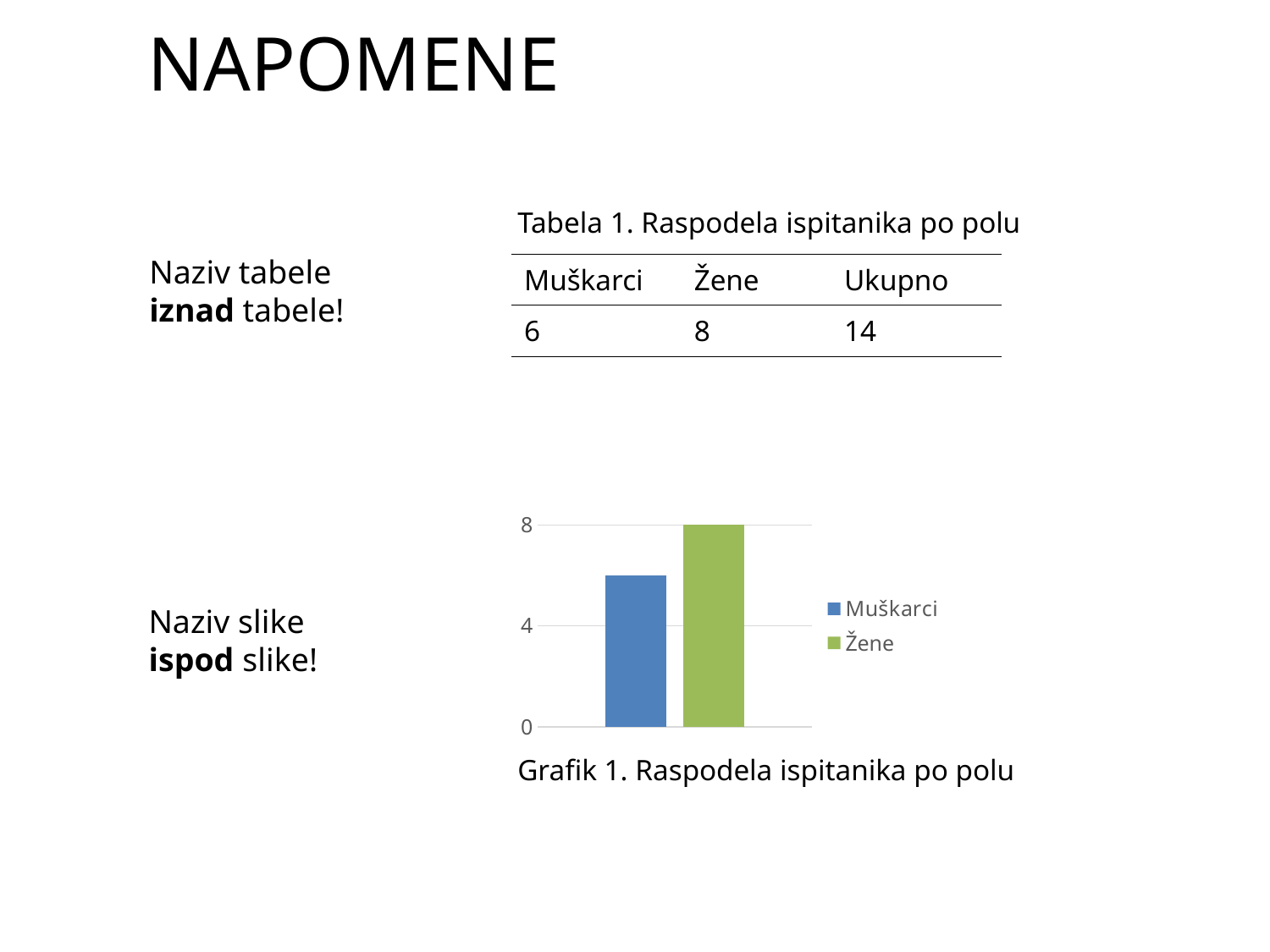
Which series has the lowest value in the chart? Muškarci What is the difference between the Žene and Muškarci values in the chart? 2 Which series has the highest value in the chart? Žene What is the value of the Muškarci bar in the chart? 6 Which bar is taller in the chart, Muškarci or Žene? Žene What colour is the Žene bar in the chart? green How many series does the legend of the chart list? 2 How many bars are plotted in the chart? 2 What is the caption shown below the chart? Grafik 1. Raspodela ispitanika po polu Is the value for Muškarci in the chart greater or less than 4? greater What is the value of the Žene bar in the chart? 8 What kind of chart is Grafik 1? bar chart